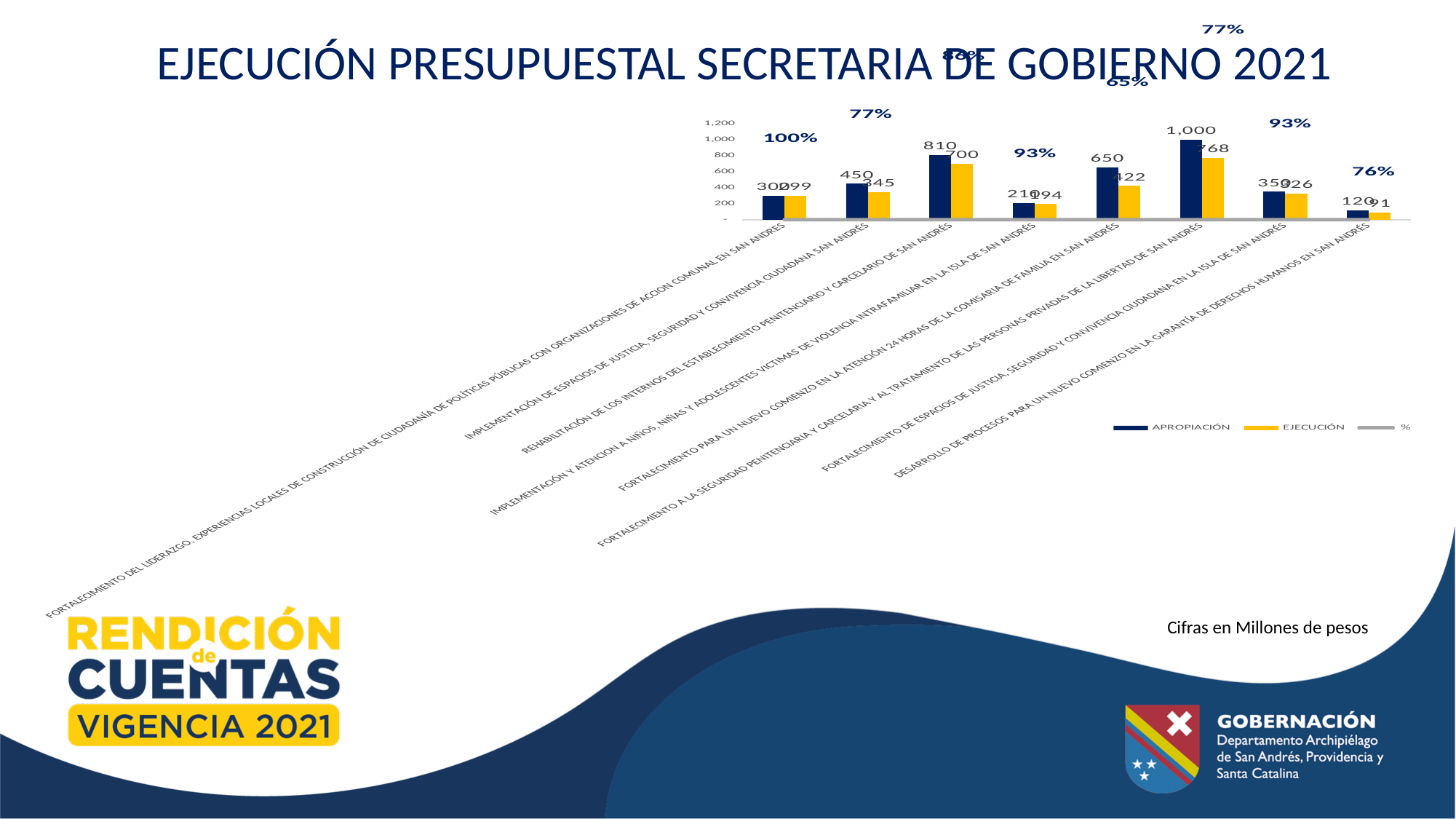
What is the difference between APROPIACIÓN (1,000) and EJECUCIÓN (768) for the category beginning 'FORTALECIMIENTO A LA SEGURIDAD PENITENCIARIA'? 232 What is the APROPIACIÓN value for the category beginning 'FORTALECIMIENTO A LA SEGURIDAD PENITENCIARIA'? 1,000 Which colour represents the EJECUCIÓN series in the chart? Yellow How many entries does the chart legend list? 3 Which category has the highest APROPIACIÓN value? FORTALECIMIENTO A LA SEGURIDAD PENITENCIARIA Y CARCELARIA Y AL TRATAMIENTO DE LAS PERSONAS PRIVADAS DE LA LIBERTAD DE SAN ANDRÉS What execution percentage (%) is shown for the category beginning 'FORTALECIMIENTO PARA UN NUEVO COMIENZO'? 65% What is the difference between APROPIACIÓN and EJECUCIÓN for the category beginning 'FORTALECIMIENTO PARA UN NUEVO COMIENZO'? 228 How many categories (projects) are plotted on the chart? 8 What kind of chart is shown on the slide? Bar chart What is the APROPIACIÓN value for the category beginning 'FORTALECIMIENTO PARA UN NUEVO COMIENZO'? 650 Which category has the lowest APROPIACIÓN value? DESARROLLO DE PROCESOS PARA UN NUEVO COMIENZO EN LA GARANTÍA DE DERECHOS HUMANOS EN SAN ANDRÉS What is the EJECUCIÓN value for the category beginning 'REHABILITACIÓN DE LOS INTERNOS DEL ESTABLECIMIENTO PENITENCIARIO'? 700